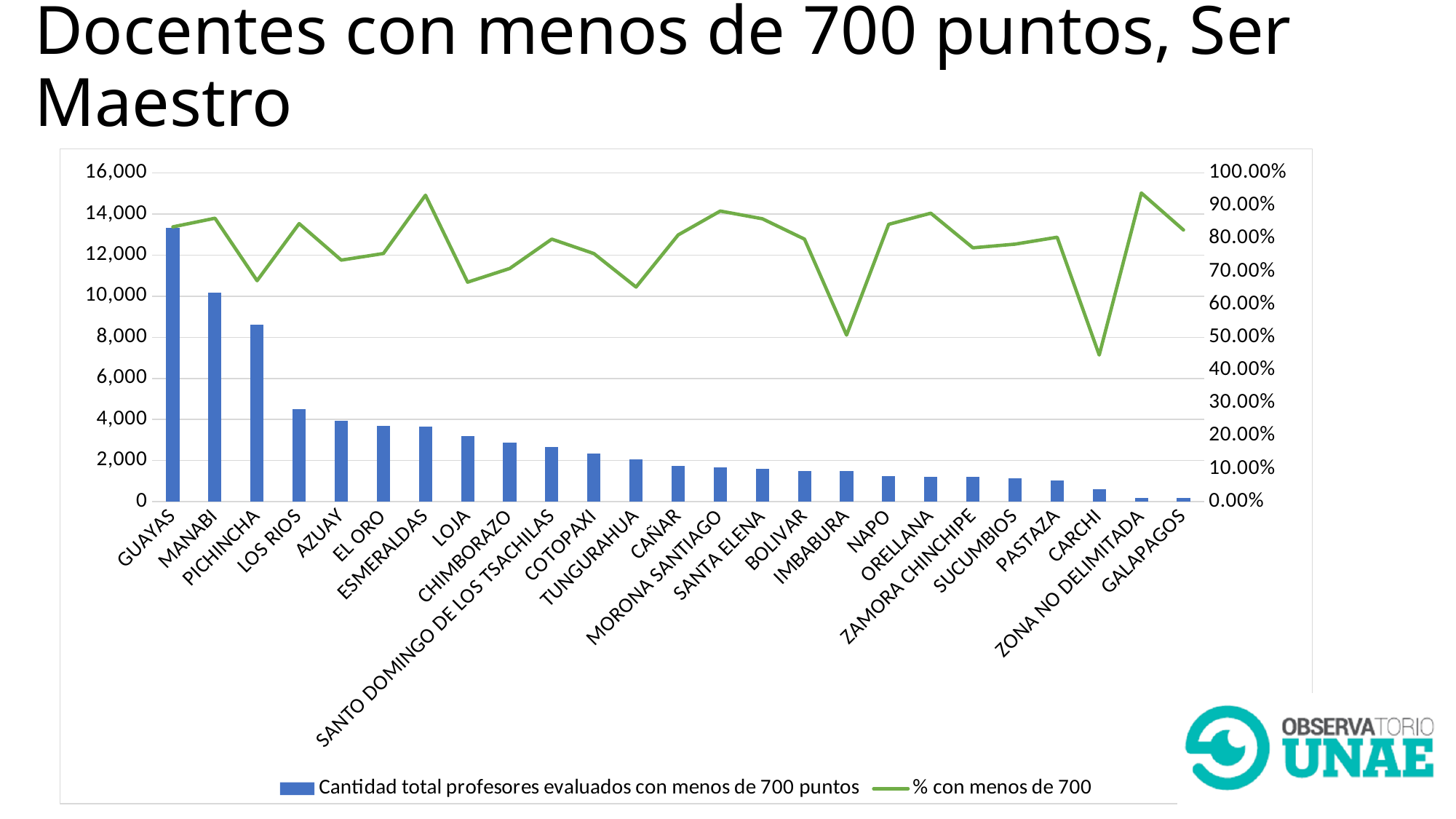
How many series does the legend list? 2 Which province has the highest bar for 'Cantidad total profesores evaluados con menos de 700 puntos'? GUAYAS Do the bar values rise or fall moving from left to right along the x axis? fall How many provinces (categories) are shown on the x axis? 25 Is the '% con menos de 700' value for CARCHI greater or less than 50.00%? less Which province has the lowest value on the '% con menos de 700' line? CARCHI Is the bar value for PICHINCHA greater or less than 10,000? less Is the '% con menos de 700' value for GUAYAS greater or less than 80.00%? greater Which has the larger bar, MANABI or PICHINCHA? MANABI What kind of chart is shown on the slide? A combined bar and line chart